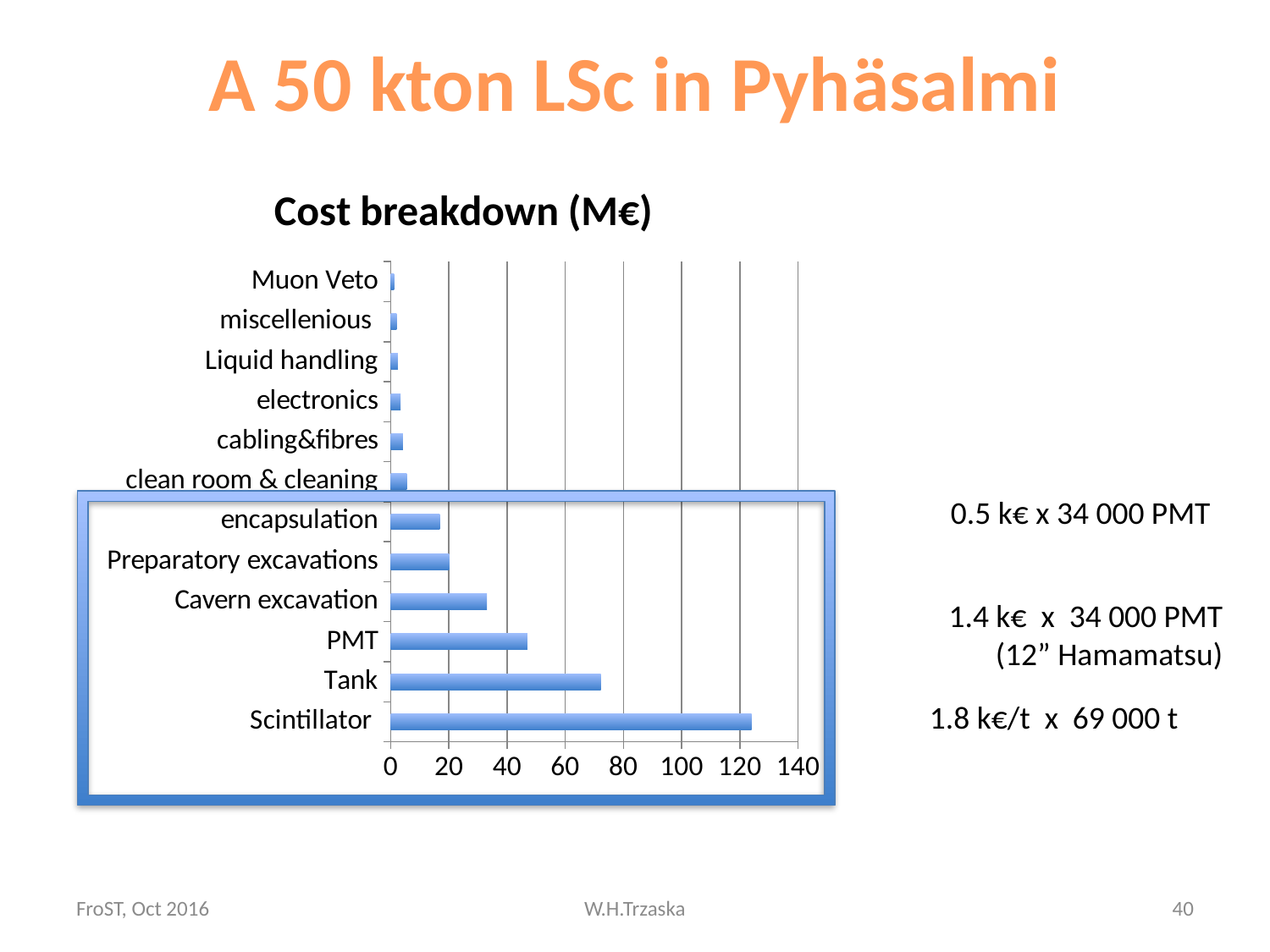
Is the value for encapsulation greater or less than 20? less Is the value for PMT greater or less than 40? greater Is the value for Tank greater or less than 60? greater What type of chart is shown on the slide? bar chart What is the title of the chart? Cost breakdown (M€) Which is larger, the value for Tank or the value for PMT? Tank Which category has the highest cost in the chart? Scintillator Which is larger, the value for Cavern excavation or the value for encapsulation? Cavern excavation How many categories are plotted in the chart? 12